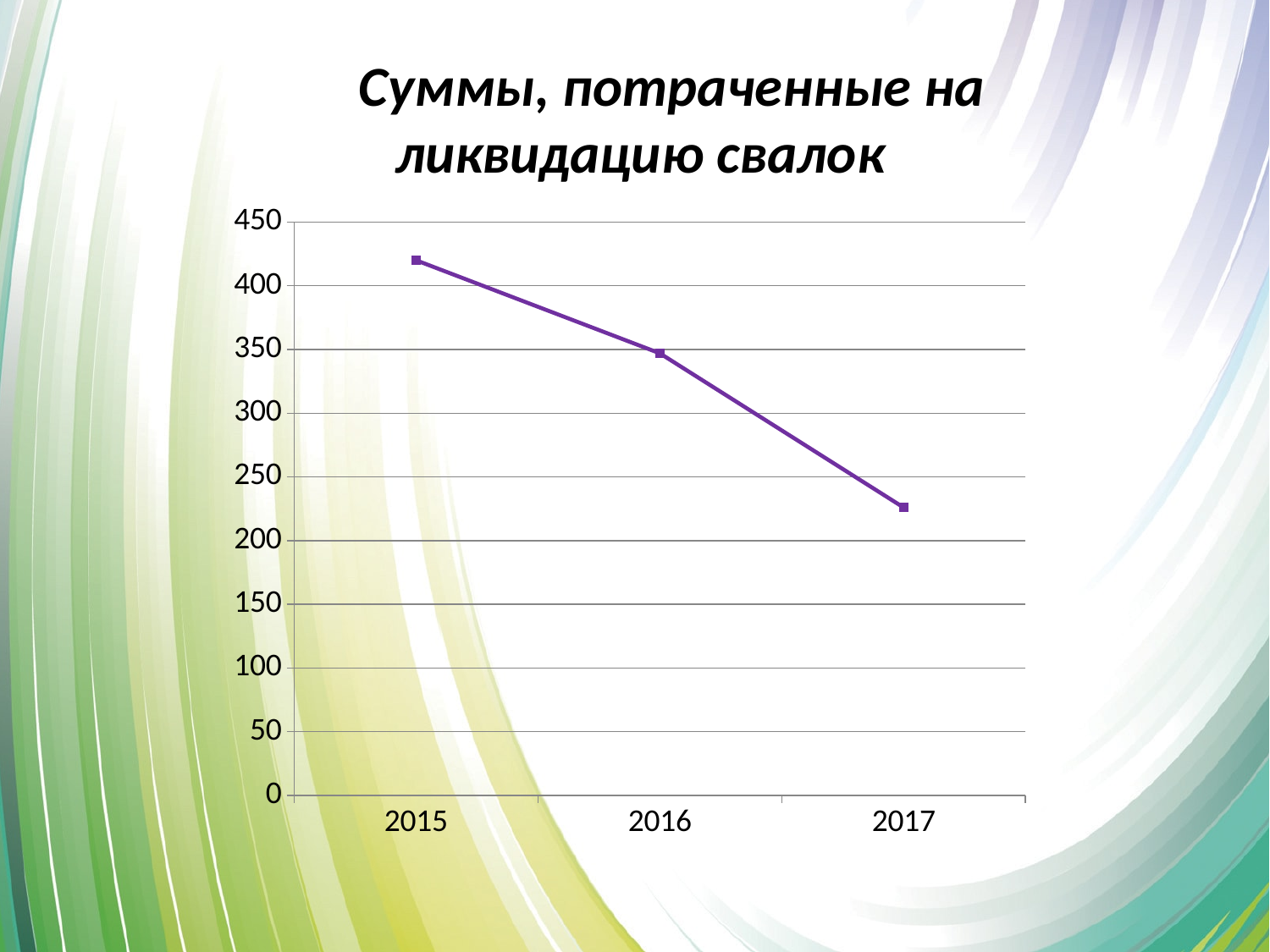
Which is larger, the value for 2016 or the value for 2017? 2016 Is the value for 2016 greater or less than 300? greater What is the title of the chart? Суммы, потраченные на ликвидацию свалок Do the values rise or fall from 2015 to 2017? fall Is the value for 2017 greater or less than 250? less Is the value for 2015 greater or less than 400? greater Which year has the highest value? 2015 Which year has the lowest value? 2017 What kind of chart is shown on the slide? line chart How many years are plotted on the x axis? 3 What is the highest value shown on the vertical axis? 450